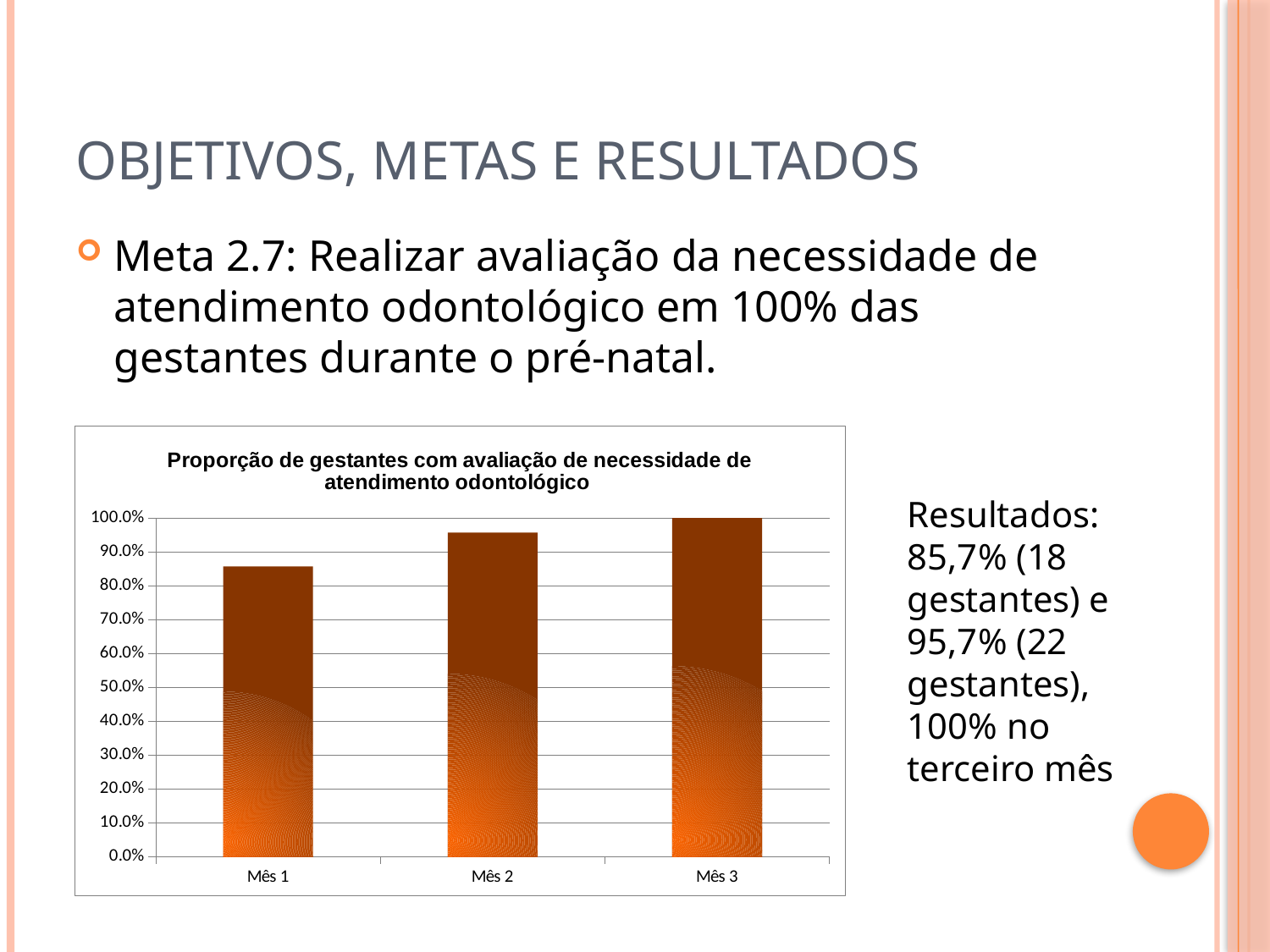
What is the value for Mês 3 on the chart? 100.0% What is the title of the chart? Proporção de gestantes com avaliação de necessidade de atendimento odontológico Which month has the highest proportion of gestantes com avaliação de necessidade de atendimento odontológico? Mês 3 How many categories (months) are plotted on the chart? 3 Do the values rise or fall from Mês 1 to Mês 3? rise Which month has the lowest proportion on the chart? Mês 1 What kind of chart is shown on the slide? bar chart Is the value for Mês 1 greater or less than 90.0%? less What is the highest tick shown on the chart's vertical axis? 100.0% Which is larger, the value for Mês 1 or the value for Mês 2? Mês 2 Is the value for Mês 1 greater or less than 80.0%? greater Is the value for Mês 2 greater or less than 90.0%? greater